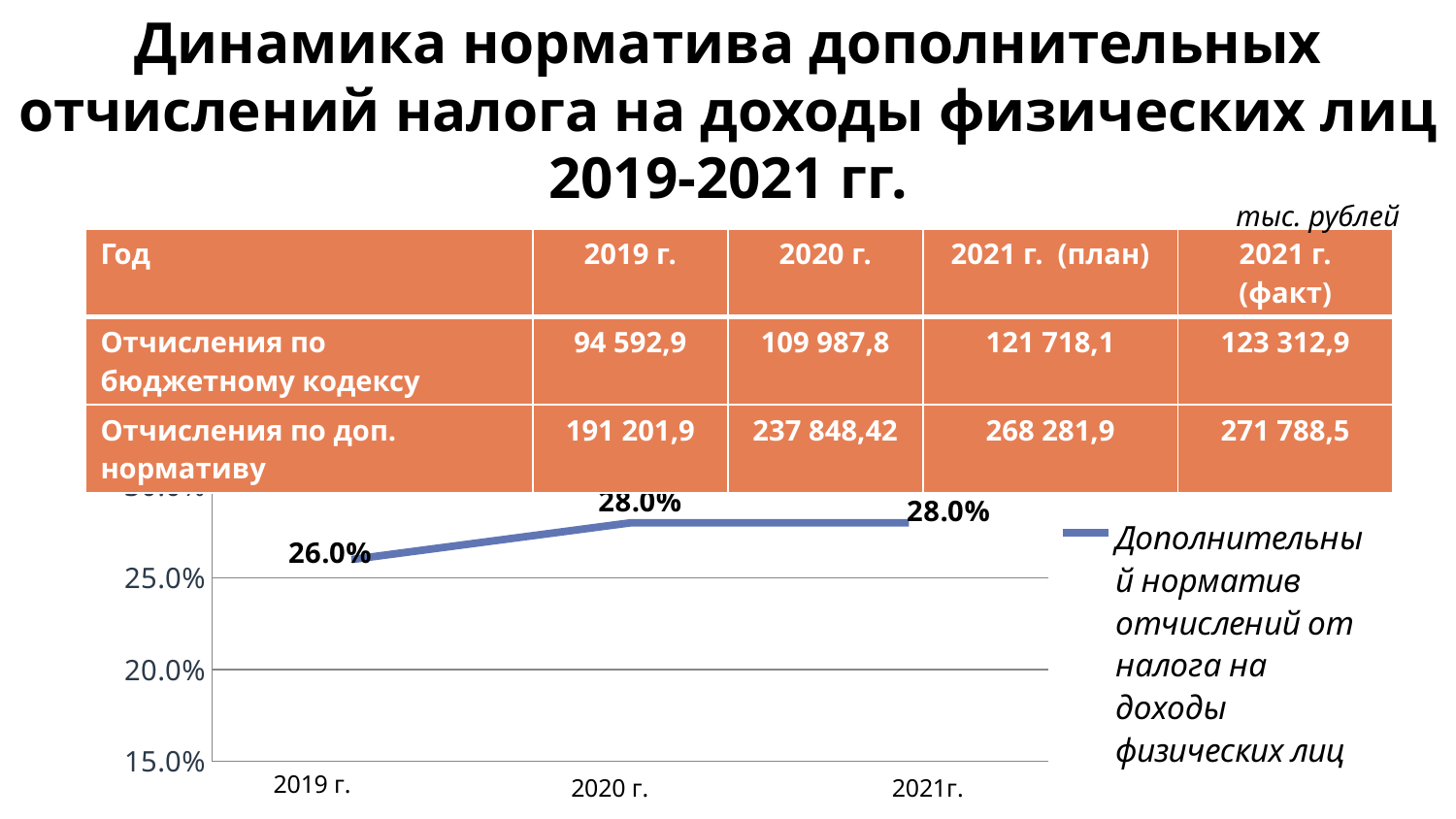
Which year has the lowest value on the line chart? 2019 г. Which is larger on the line chart, the value for 2019 г. or the value for 2020 г.? 2020 г. Do the values on the line chart rise or fall from 2019 г. to 2020 г.? rise What is the legend entry of the series on the line chart? Дополнительный норматив отчислений от налога на доходы физических лиц What is the value for 2020 г. on the line chart? 28.0% What kind of chart is shown at the bottom of the slide? line chart How many series does the legend of the line chart list? 1 Is the value for 2019 г. on the line chart greater or less than 25.0%? greater What is the difference between the values for 2020 г. and 2019 г. on the line chart? 2.0% What is the value for 2021г. on the line chart? 28.0% How many data points are plotted on the line chart? 3 What is the value for 2019 г. on the line chart? 26.0%